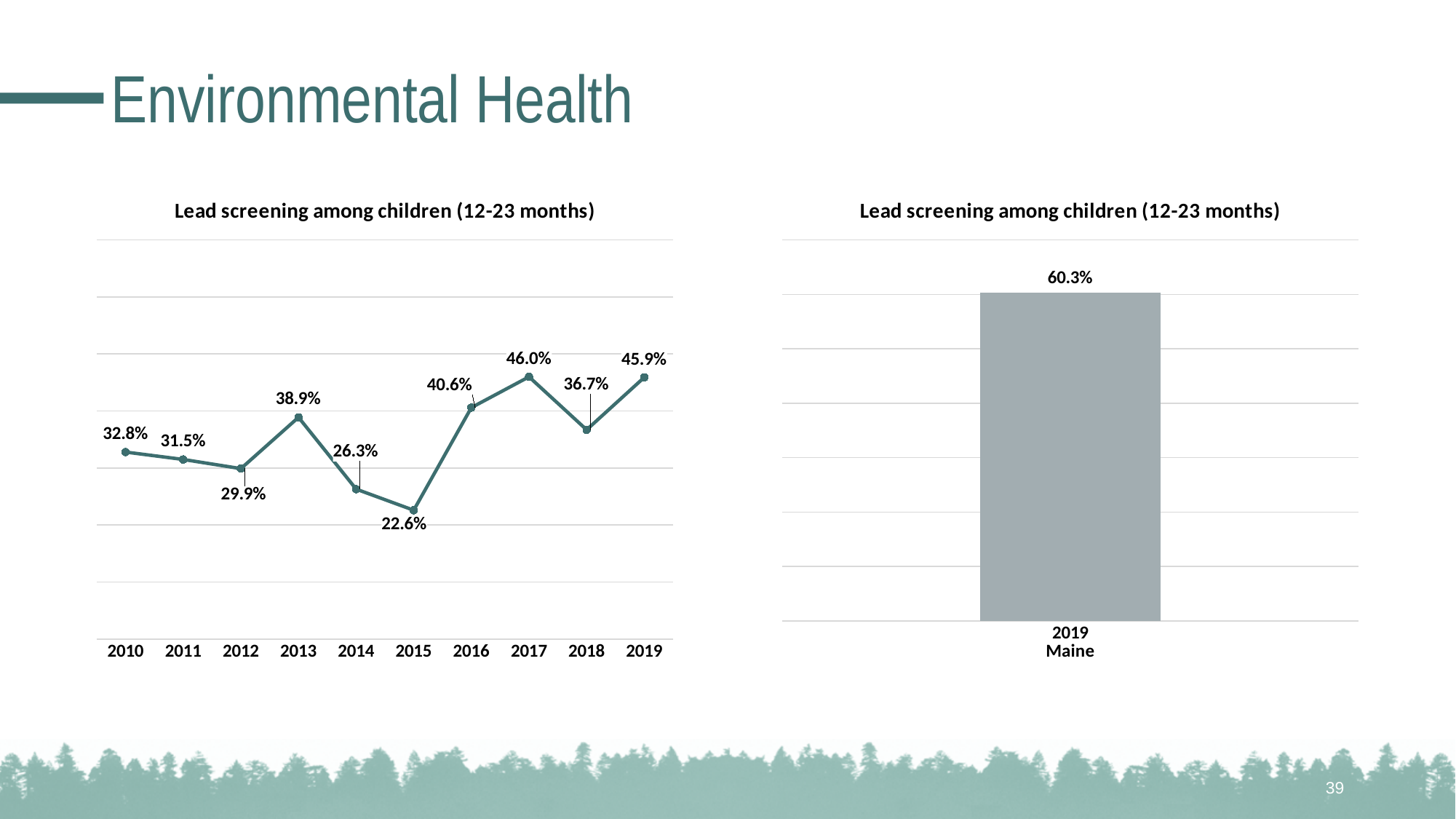
In the right chart, what was the lead screening rate among children in Maine in 2019? 60.3% What kind of chart is the right chart? Bar chart In the left chart, what was the lead screening rate among children in 2013? 38.9% In the left chart, what was the lead screening rate among children in 2019? 45.9% In the left chart, which year had a higher lead screening rate, 2016 or 2018? 2016 How many years are plotted in the left chart? 10 In the left chart, which year had the lowest lead screening rate? 2015 In the left chart, did the lead screening rate rise or fall from 2010 to 2012? Fall In the left chart, what is the difference between the lead screening rates in 2017 and 2018? 9.3% What kind of chart is the left chart? Line chart In the left chart, what was the lead screening rate among children in 2015? 22.6% In the left chart, which year had the highest lead screening rate? 2017